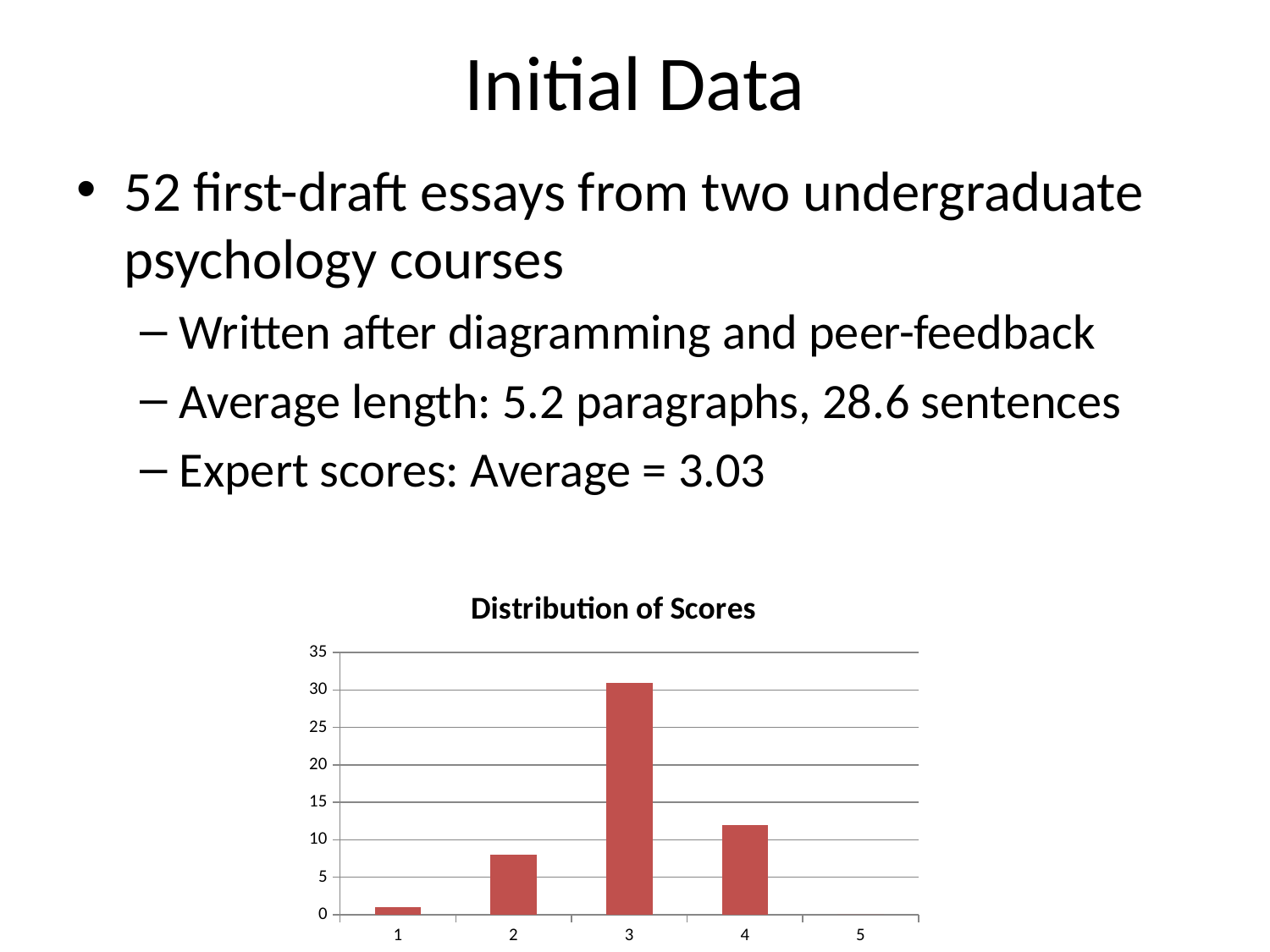
What is the title of the chart? Distribution of Scores How many score categories are shown on the x axis of the chart? 5 Is the value for score 2 greater or less than 10? less Which score category has the highest bar in the chart? 3 Is the value for score 3 greater or less than 25? greater Which has the larger value, score 1 or score 2? 2 What type of chart is shown on the slide? bar chart Which score category has the lowest value in the chart? 5 Is the value for score 1 greater or less than 5? less What colour are the bars in the chart? red Which has the larger value, score 2 or score 4? 4